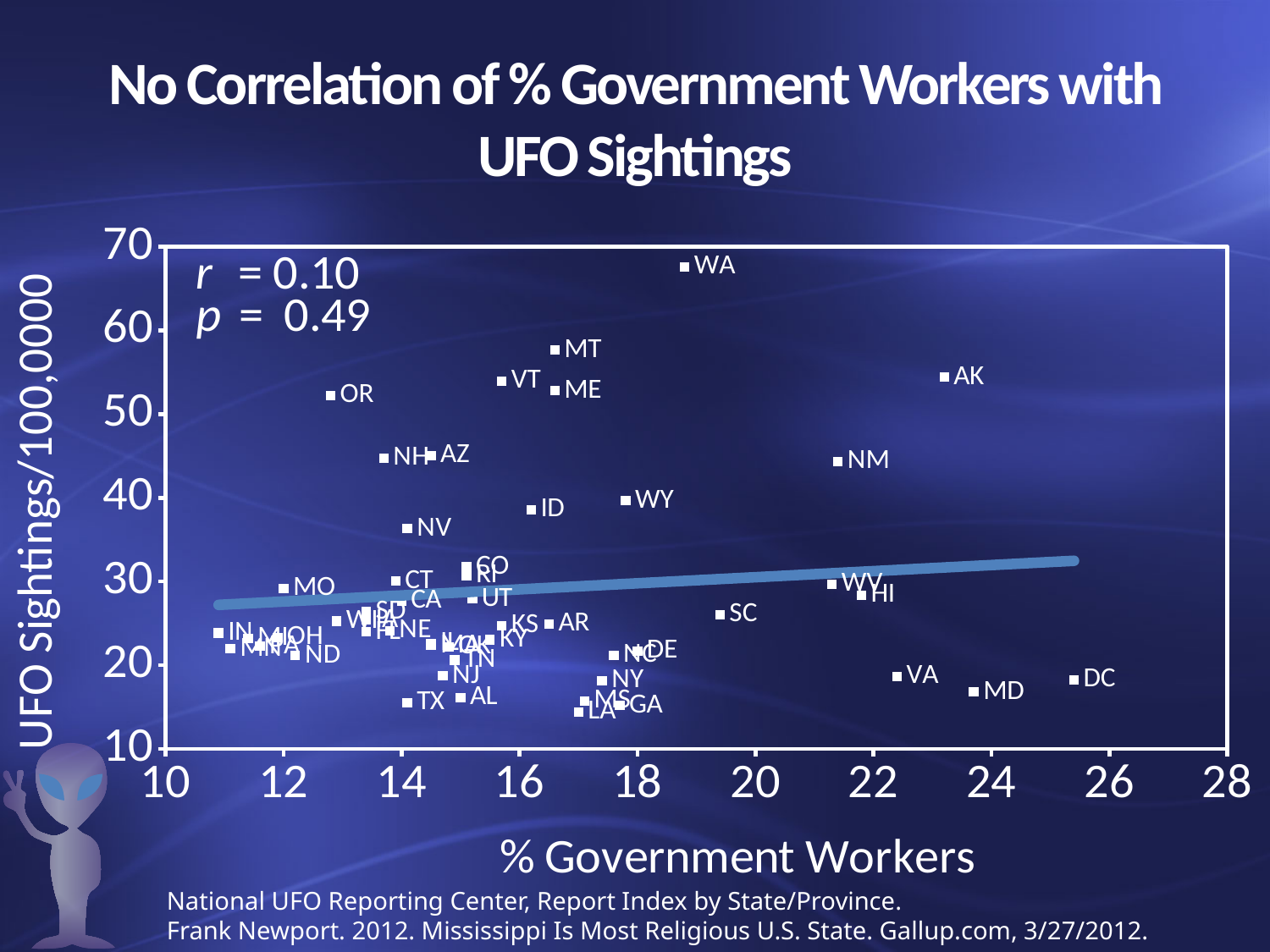
Is the % government workers value for DC greater or less than 24? greater Which state has a higher % government workers, AK or OR? AK What kind of chart is shown on the slide? scatter plot Is the UFO sightings value for AK greater or less than 50? greater What is the correlation coefficient r shown on the chart? 0.10 Which state has the highest % government workers? DC Which state has more UFO sightings per 100,000, WA or MT? WA Is the % government workers value for OR greater or less than 14? less Does the fitted trend line rise or fall as % government workers increases? rises Which state has the highest UFO sightings per 100,000? WA